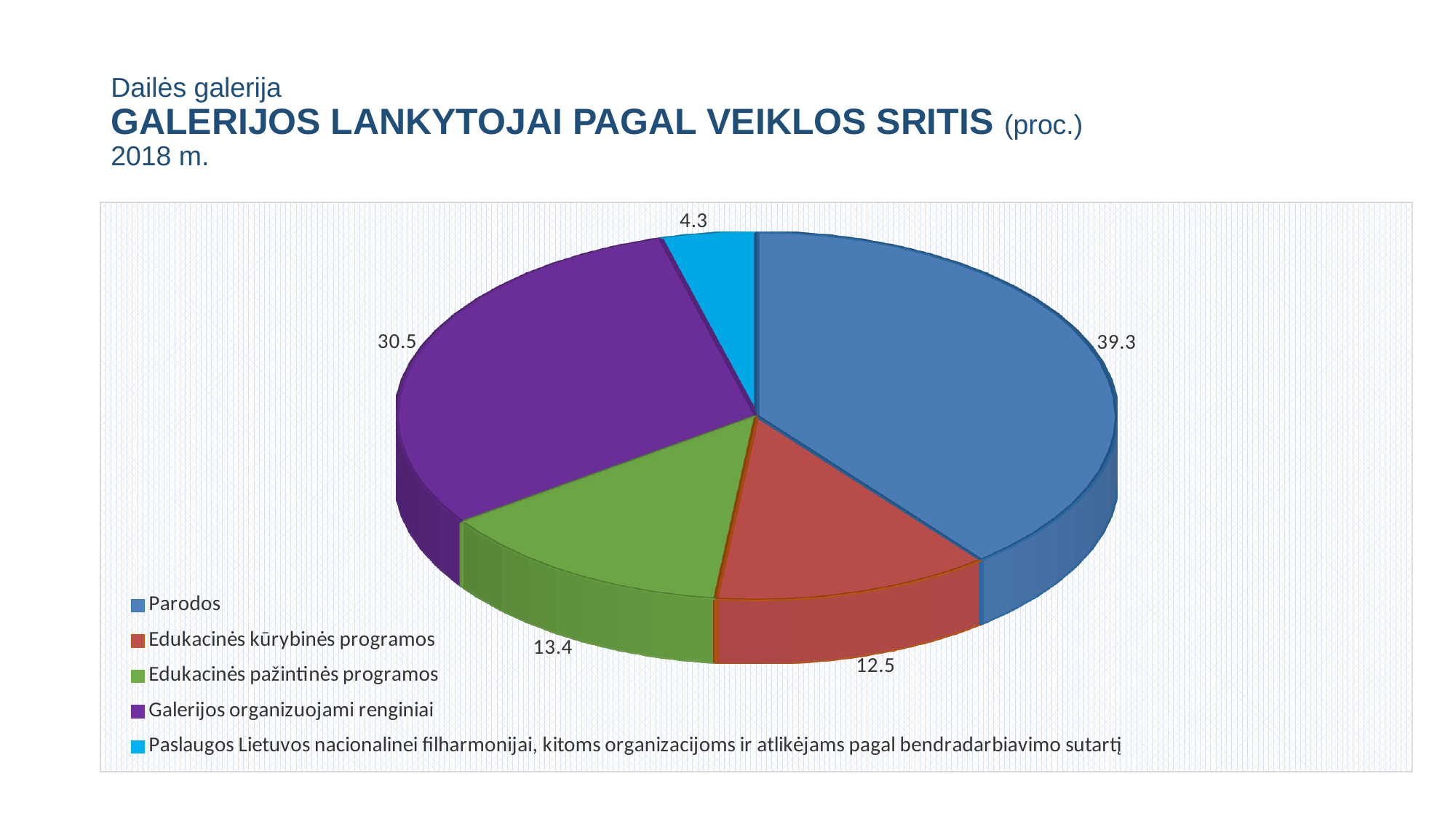
Which category has the smallest share of the pie? Paslaugos Lietuvos nacionalinei filharmonijai, kitoms organizacijoms ir atlikėjams pagal bendradarbiavimo sutartį What is the value for Paslaugos Lietuvos nacionalinei filharmonijai, kitoms organizacijoms ir atlikėjams pagal bendradarbiavimo sutartį? 4.3 Which is larger, Edukacinės pažintinės programos or Edukacinės kūrybinės programos? Edukacinės pažintinės programos How many categories does the pie chart have? 5 What colour is the slice for Galerijos organizuojami renginiai? purple What is the value for Galerijos organizuojami renginiai? 30.5 What is the difference between the values for Parodos and Galerijos organizuojami renginiai? 8.8 What is the value for Parodos? 39.3 What is the value for Edukacinės kūrybinės programos? 12.5 What is the value for Edukacinės pažintinės programos? 13.4 Which category has the largest share of the pie? Parodos What kind of chart is shown on the slide? pie chart